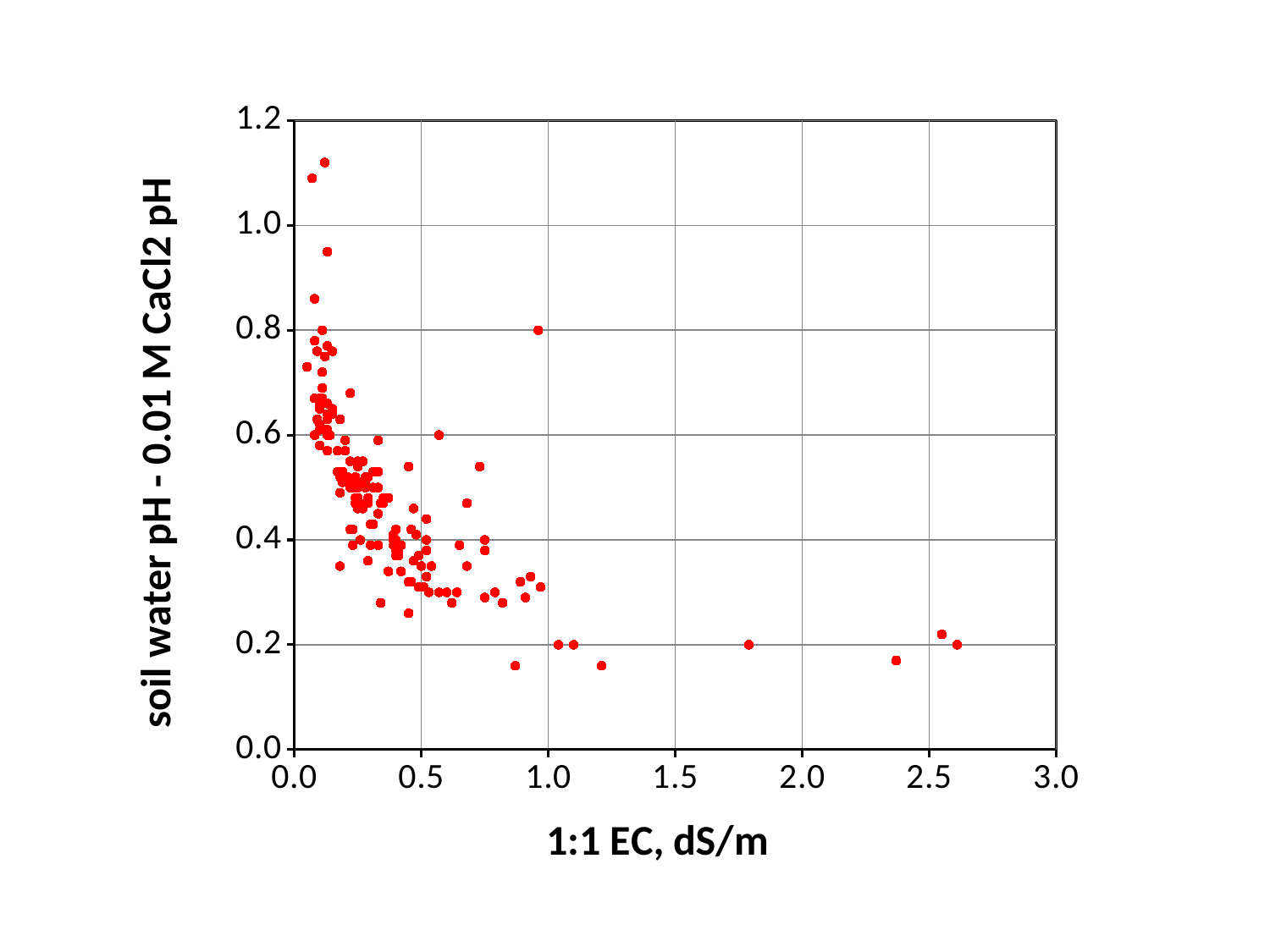
Is the y value of the highest point on the chart greater or less than 1.0? greater Is the y value of the point with the largest 1:1 EC (near 2.6 dS/m) greater or less than 0.4? less What kind of chart is shown on the slide? scatter plot Is the y value of the isolated point near 1:1 EC of 1.0 dS/m greater or less than 0.6? greater What is the maximum value shown on the x axis? 3.0 What is the maximum value shown on the y axis? 1.2 Overall, do the y values rise or fall as the 1:1 EC increases along the x axis? fall What is the label of the x axis? 1:1 EC, dS/m